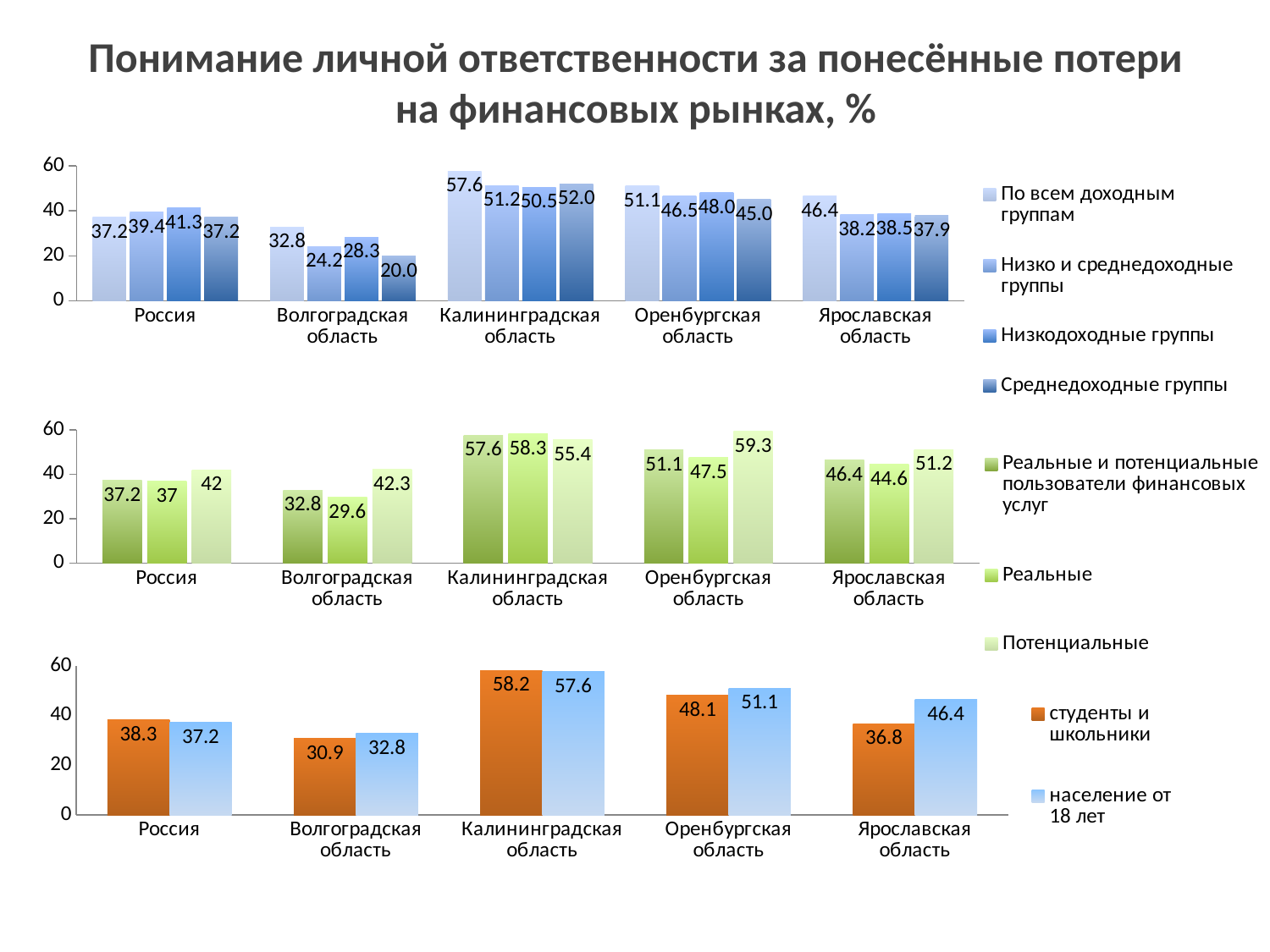
In the top chart, what is the value for Среднедоходные группы in Волгоградская область? 20.0 In the top chart, how many series does the legend list? 4 How many regions (categories) are shown on the x axis of the bottom chart? 5 In the bottom chart, what is the value for студенты и школьники in Ярославская область? 36.8 In the middle chart, which region has the lowest value for Реальные? Волгоградская область In the top chart, which region has the highest value for По всем доходным группам? Калининградская область In the bottom chart, which is larger in Оренбургская область: студенты и школьники or население от 18 лет? население от 18 лет What type of chart is the bottom chart? bar chart In the top chart, what is the value for Низкодоходные группы in Россия? 41.3 In the middle chart, what is the value for Потенциальные in Оренбургская область? 59.3 In the middle chart, what is the difference between Потенциальные and Реальные in Волгоградская область? 12.7 In the bottom chart, what is the difference between население от 18 лет and студенты и школьники in Ярославская область? 9.6